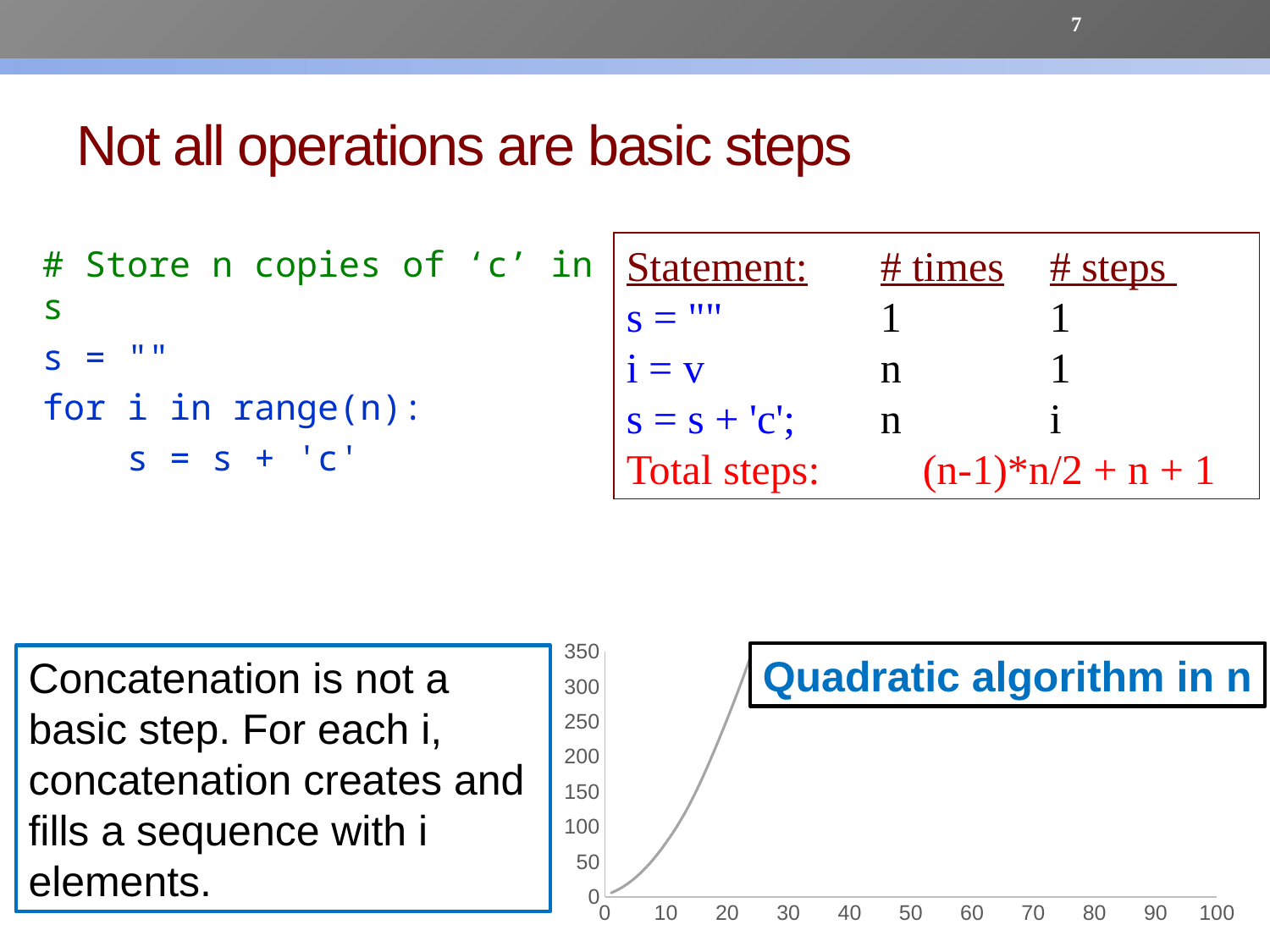
What is the largest value shown on the chart's x axis? 100 Is the value of the curve at x = 10 greater or less than 50? greater Is the value of the curve at x = 10 greater or less than 200? less Do the values on the chart rise or fall as the x axis increases from 0? rise What kind of chart is shown at the bottom right of the slide? line chart What is the highest value shown on the chart's y axis? 350